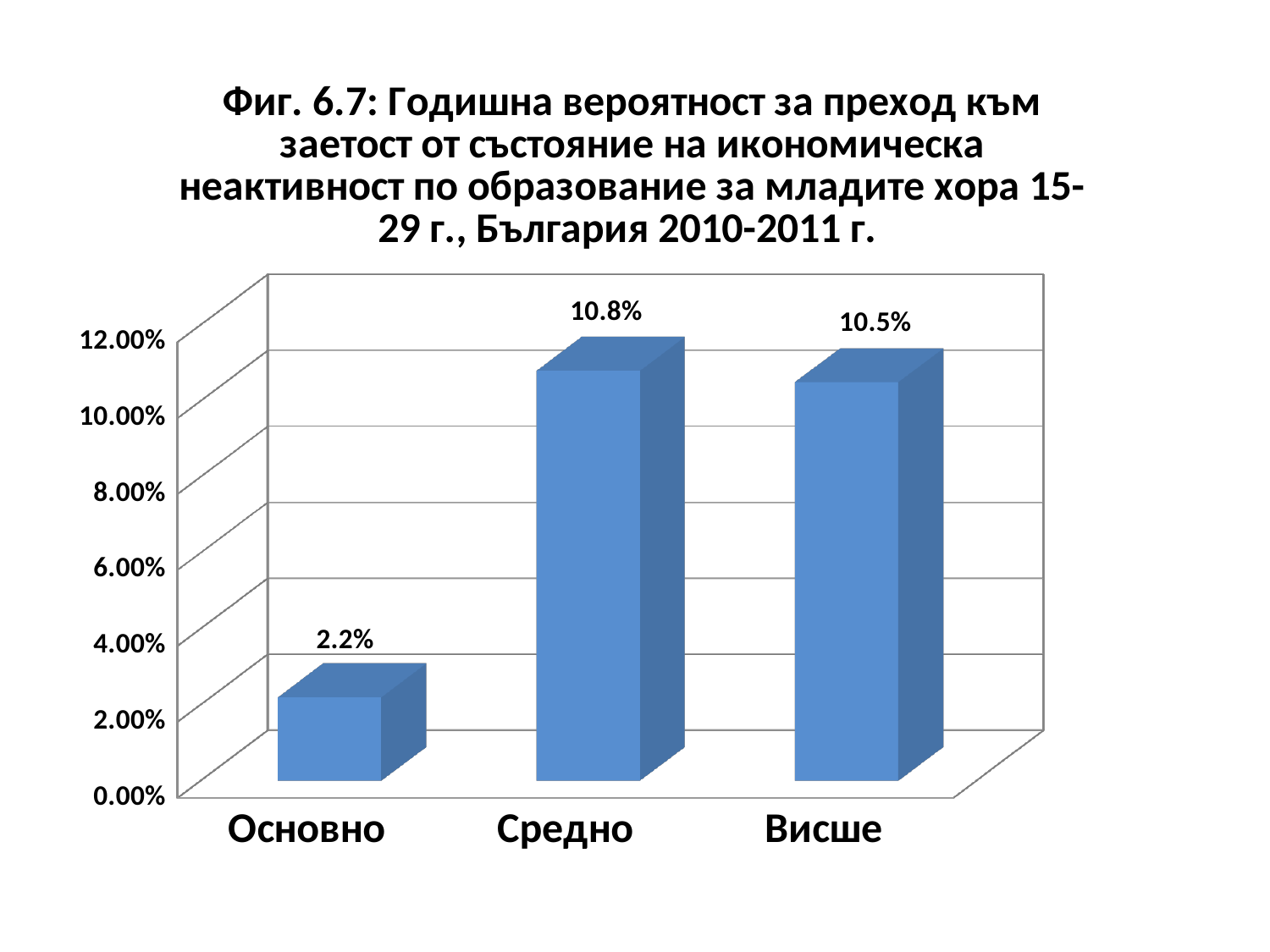
What is the value for Висше? 10.5% Which category has the highest value? Средно Is the value for Основно greater or less than 4.00%? less What is the value for Основно? 2.2% What is the difference between the values for Средно and Основно? 8.6% Which is larger, the value for Висше or the value for Основно? Висше How many categories are shown on the x axis? 3 What kind of chart is shown on the slide? bar chart What is the difference between the values for Средно and Висше? 0.3% Which category has the lowest value? Основно What is the value for Средно? 10.8% What is the figure number given in the chart title? Фиг. 6.7